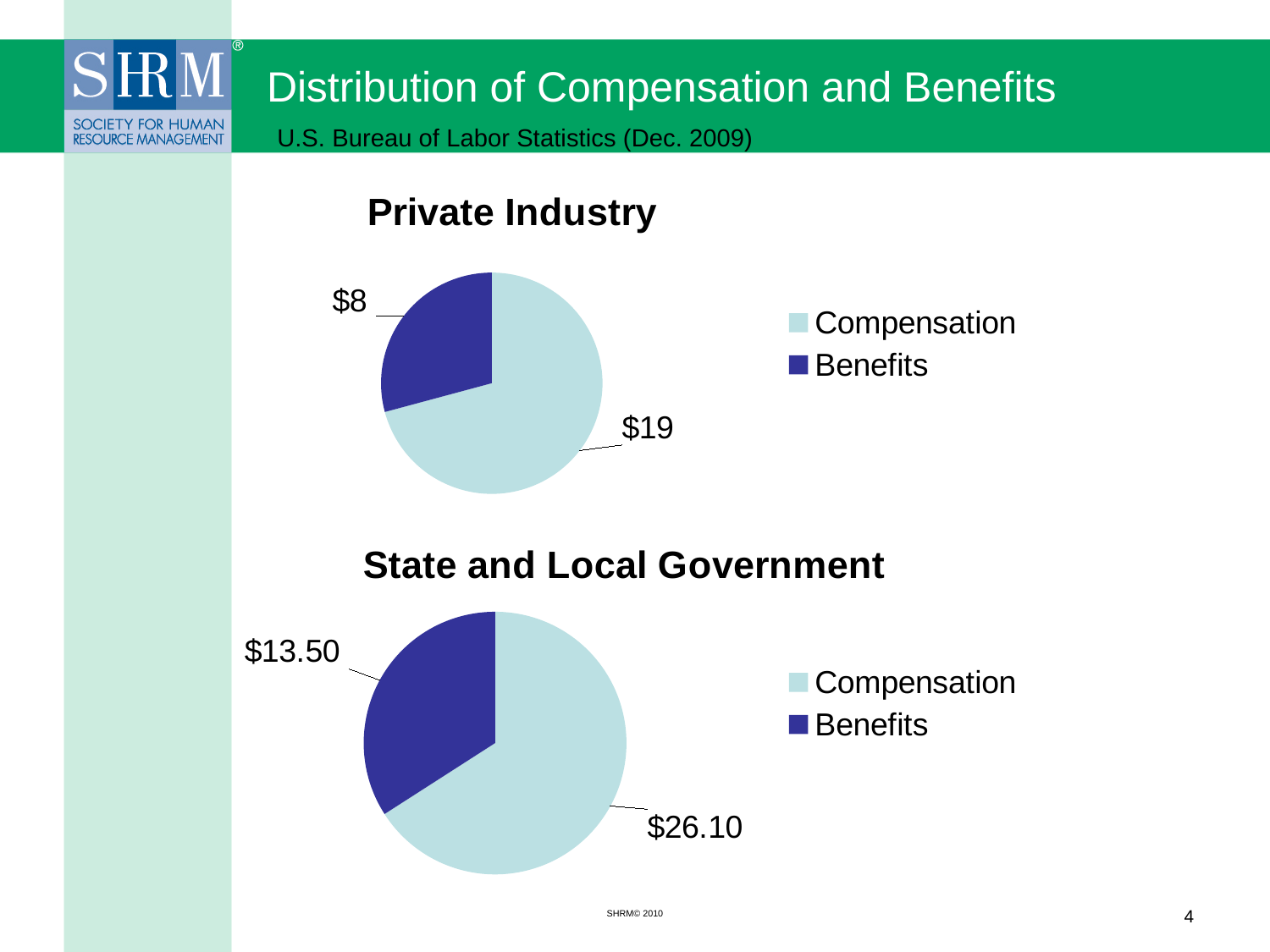
In the Private Industry chart, which slice is the largest? Compensation What type of chart is the Private Industry chart? Pie chart In the State and Local Government chart, what is the value for Compensation? $26.10 In the Private Industry chart, what is the value for Compensation? $19 In the State and Local Government chart, what is the difference between Compensation and Benefits? $12.60 In the Private Industry chart, what is the value for Benefits? $8 In the Private Industry chart, what is the difference between Compensation and Benefits? $11 In the State and Local Government chart, which slice is the smallest? Benefits How many slices does the State and Local Government pie chart have? 2 Is the Benefits value larger in the Private Industry chart or in the State and Local Government chart? State and Local Government In the State and Local Government chart, what is the value for Benefits? $13.50